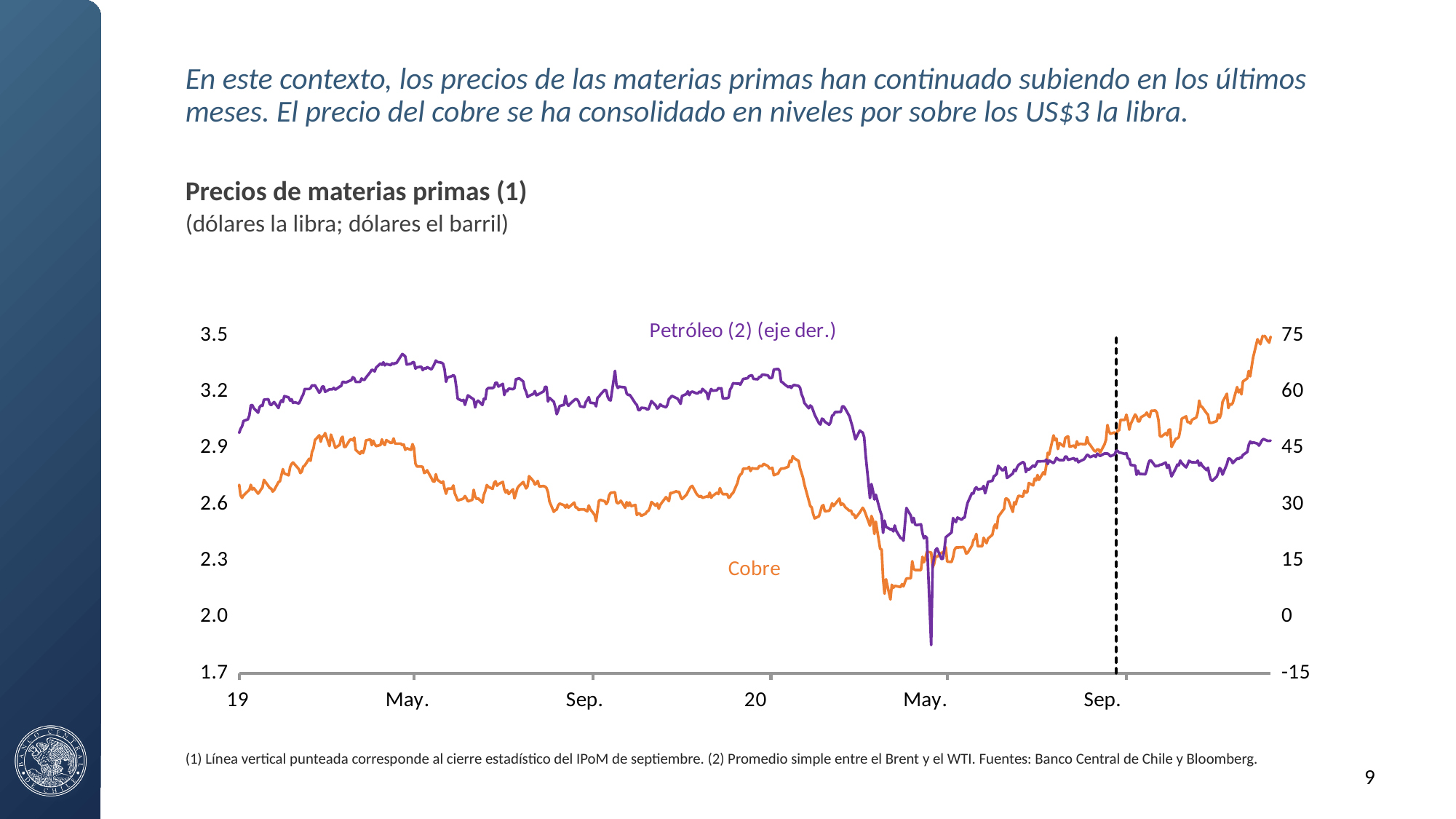
Is the value of Cobre at the end of the series (right edge of the chart) greater or less than 3.2? greater Is the highest value of Petróleo, reached in 2019, greater or less than 60 on the right axis? greater What is the title of the chart? Precios de materias primas (1) Is the lowest value of Cobre, reached around May 2020, greater or less than 2.3? less How many series are plotted in the chart? 2 What is the lowest tick value shown on the right axis? -15 What is the highest tick value shown on the left axis? 3.5 Does the Cobre series rise or fall between Sep. 2020 and the end of the series? rise What kind of chart is shown on the slide? Line chart Does the Petróleo series rise or fall overall between the start of 2020 and May 2020? fall